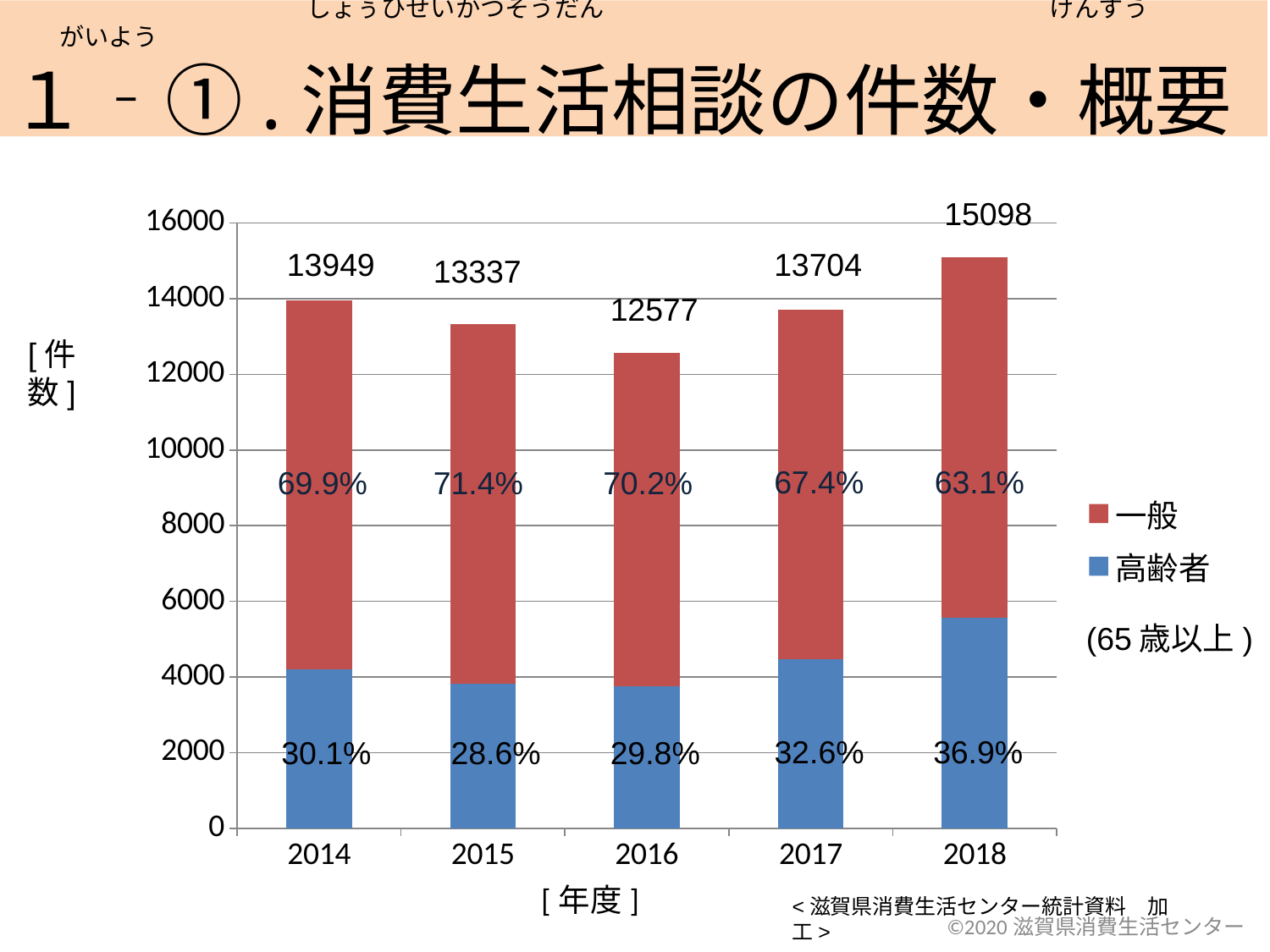
How many series does the legend list? 2 Is the value of the 高齢者 segment for 2018 greater or less than 4000? greater What is the difference between the total for 2018 and the total for 2016? 2521 Which year has a larger total, 2014 or 2017? 2014 How many years are shown on the x axis? 5 What percentage label is shown on the 一般 segment of the 2016 bar? 70.2% Which year has the lowest total number of consultations? 2016 Which year has the highest total number of consultations? 2018 What is the total number of consultations (件数) shown above the bar for 2018? 15098 Does the 高齢者 percentage rise or fall from 2016 to 2018? rise What kind of chart is shown on the slide? stacked bar chart What percentage label is shown on the 高齢者 segment of the 2014 bar? 30.1%